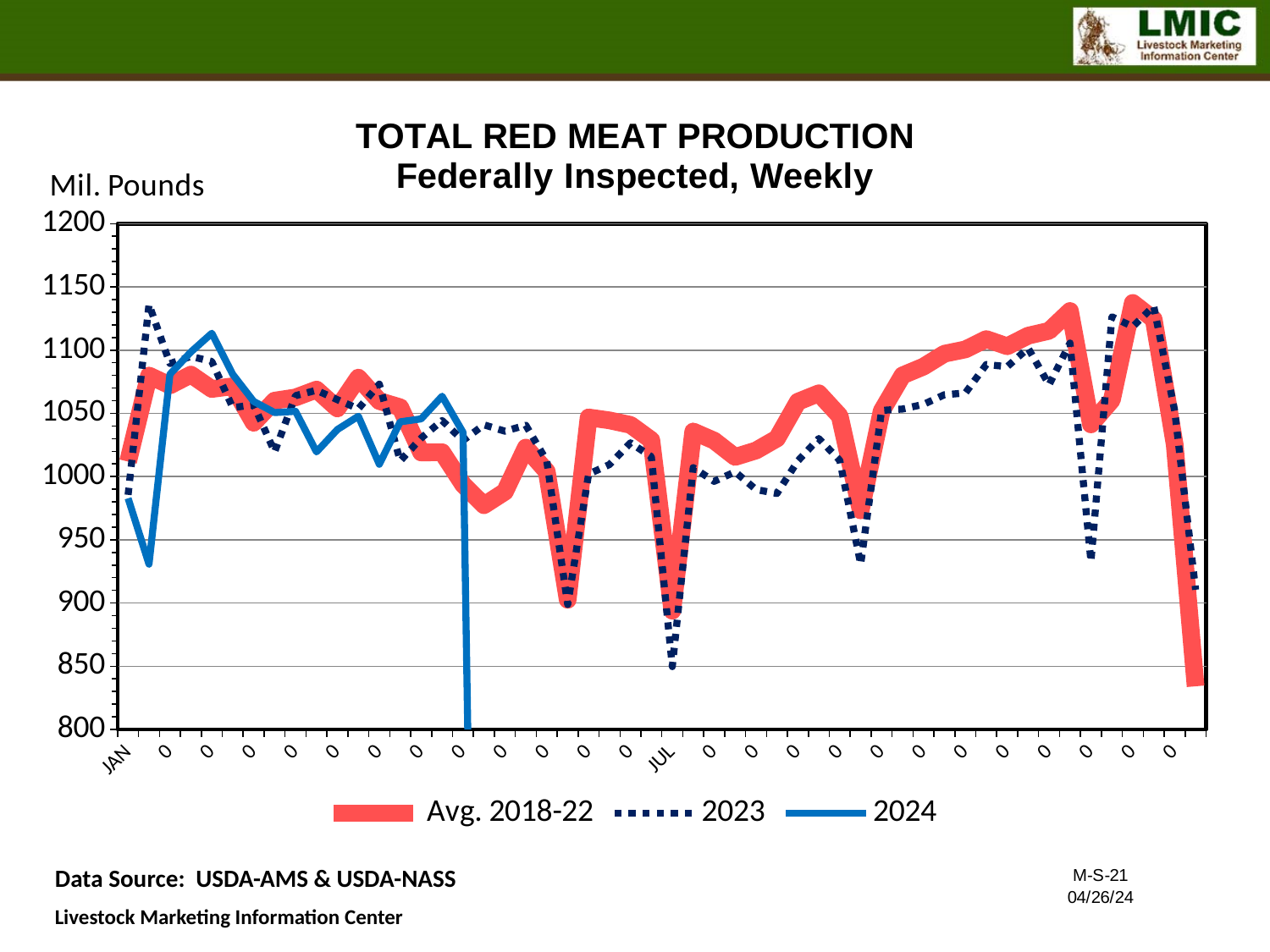
Is the value of the Avg. 2018-22 line at its dip near JUL greater or less than 950? less Is the highest value of the Avg. 2018-22 line greater or less than 1100? greater What are the three series named in the legend? Avg. 2018-22, 2023, 2024 Is the lowest value of the 2023 line, at its dip near JUL, greater or less than 900? less At JAN, which is larger: the Avg. 2018-22 value or the 2024 value? Avg. 2018-22 Does the Avg. 2018-22 line rise or fall over the last few weeks of the year after its peak? fall What kind of chart is shown on the slide? Line chart What unit is shown on the y axis of the chart? Mil. Pounds How many series does the legend list? 3